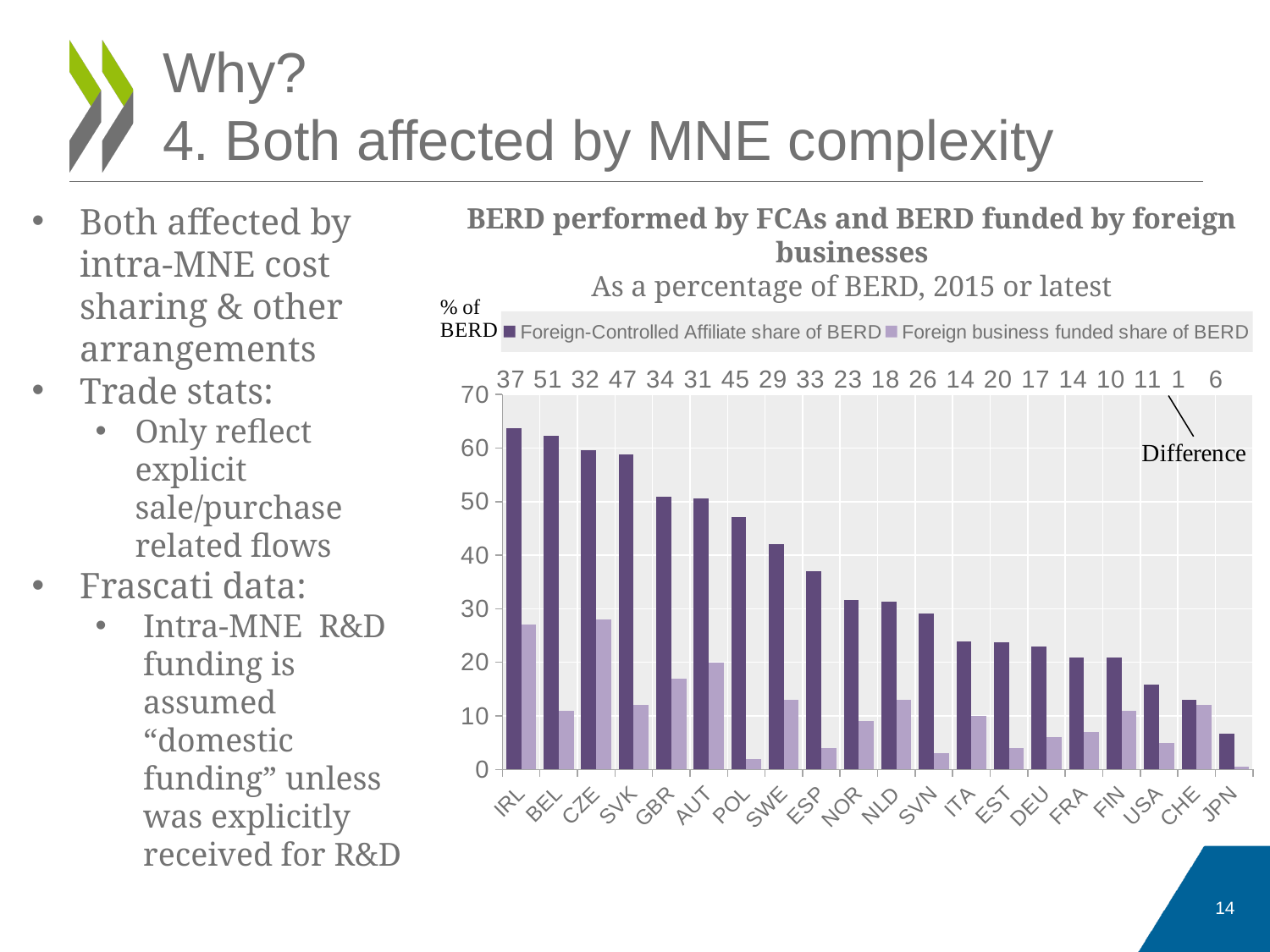
Is the Foreign-Controlled Affiliate share of BERD for IRL greater or less than 60? greater Which country has the highest printed difference value? BEL Which is larger for CZE: the Foreign-Controlled Affiliate share of BERD or the Foreign business funded share of BERD? Foreign-Controlled Affiliate share of BERD Do the Foreign-Controlled Affiliate share of BERD bars generally rise or fall from left to right along the x axis? fall What is the printed difference value above the bars for POL? 45 How many countries are shown on the x axis of the chart? 20 What is the printed difference value above the bars for BEL? 51 How many series does the chart legend list? 2 What kind of chart is shown on the slide? bar chart What is the printed difference value above the bars for CHE? 1 Is the Foreign business funded share of BERD for POL greater or less than 10? less Which country has the lowest printed difference value? CHE